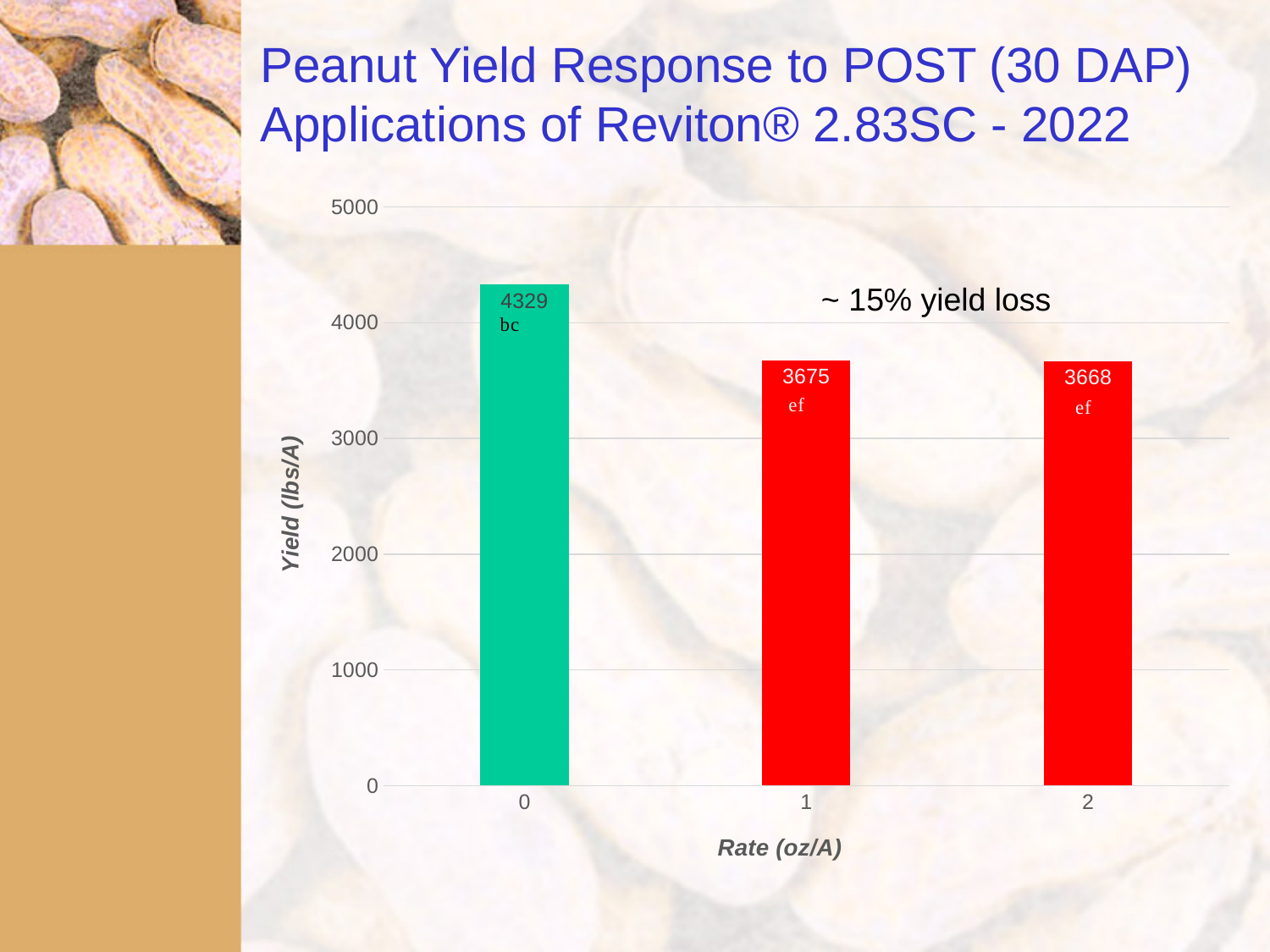
What is the yield (lbs/A) at a rate of 0 oz/A? 4329 Is the yield at 2 oz/A greater or less than 4000? less Is the yield at 0 oz/A greater or less than 4000? greater What kind of chart is shown on the slide? bar chart What is the label of the y axis? Yield (lbs/A) What is the difference in yield between the 0 oz/A rate and the 1 oz/A rate? 654 What approximate yield loss does the annotation on the chart state? ~ 15% yield loss What is the yield (lbs/A) at a rate of 1 oz/A? 3675 Which rate (oz/A) has the highest yield? 0 What is the difference in yield between the 1 oz/A rate and the 2 oz/A rate? 7 What is the yield (lbs/A) at a rate of 2 oz/A? 3668 How many rate categories are shown on the x axis? 3